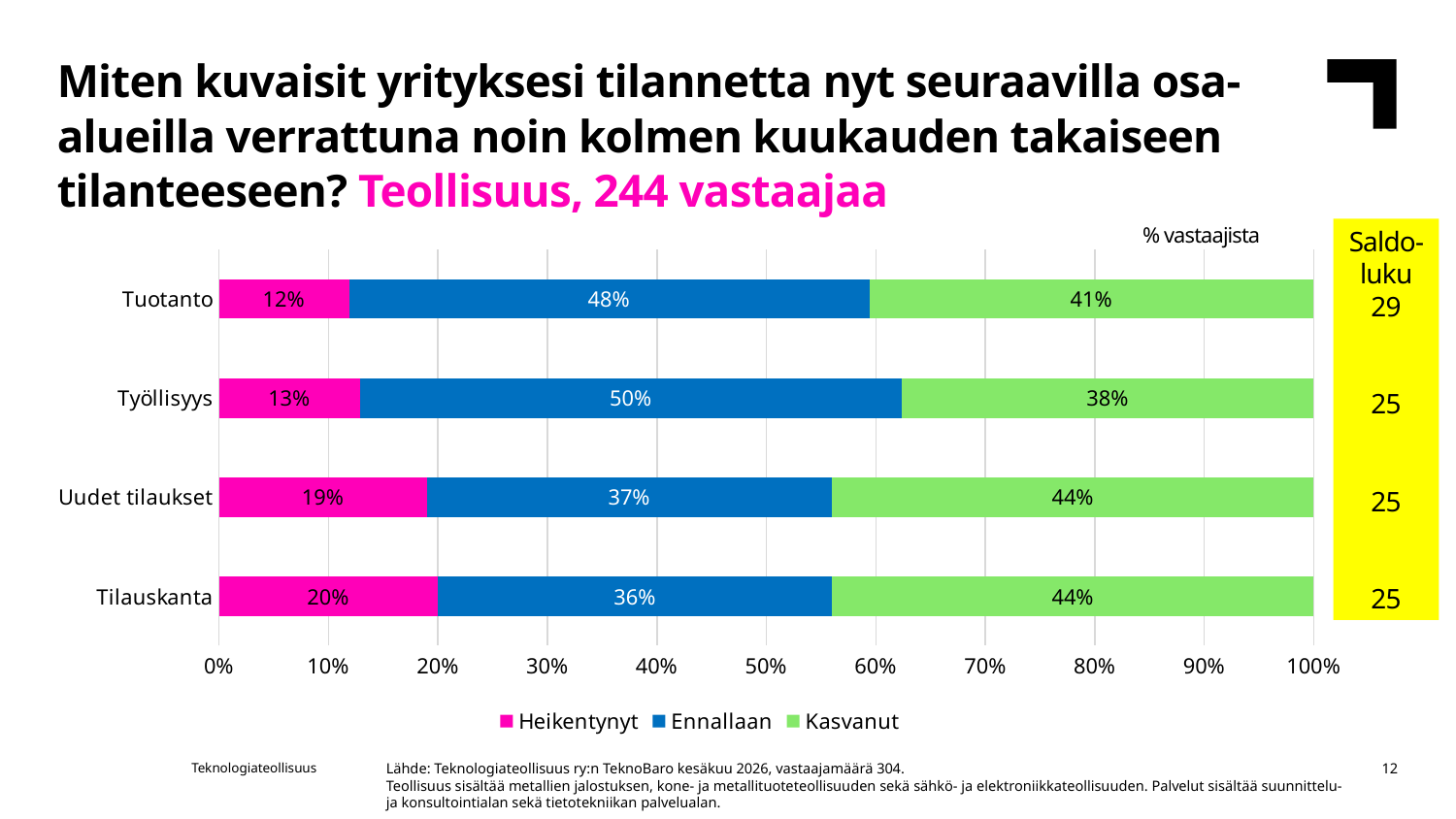
How many series does the legend list? 3 Which is larger: the Kasvanut value for Tuotanto or the Kasvanut value for Tilauskanta? Tilauskanta What is the Kasvanut value for Uudet tilaukset? 44% Which category has the lowest Ennallaan share? Tilauskanta What is the Saldoluku value shown for Tuotanto? 29 What is the difference between the Ennallaan values for Työllisyys and Uudet tilaukset? 13% What percentage of respondents answered Ennallaan for Tuotanto? 48% What kind of chart is shown on the slide? Stacked bar chart What is the Heikentynyt value for Tilauskanta? 20% How many categories are shown on the y axis of the chart? 4 Which category has the highest Heikentynyt share? Tilauskanta Which legend entry is shown in green? Kasvanut